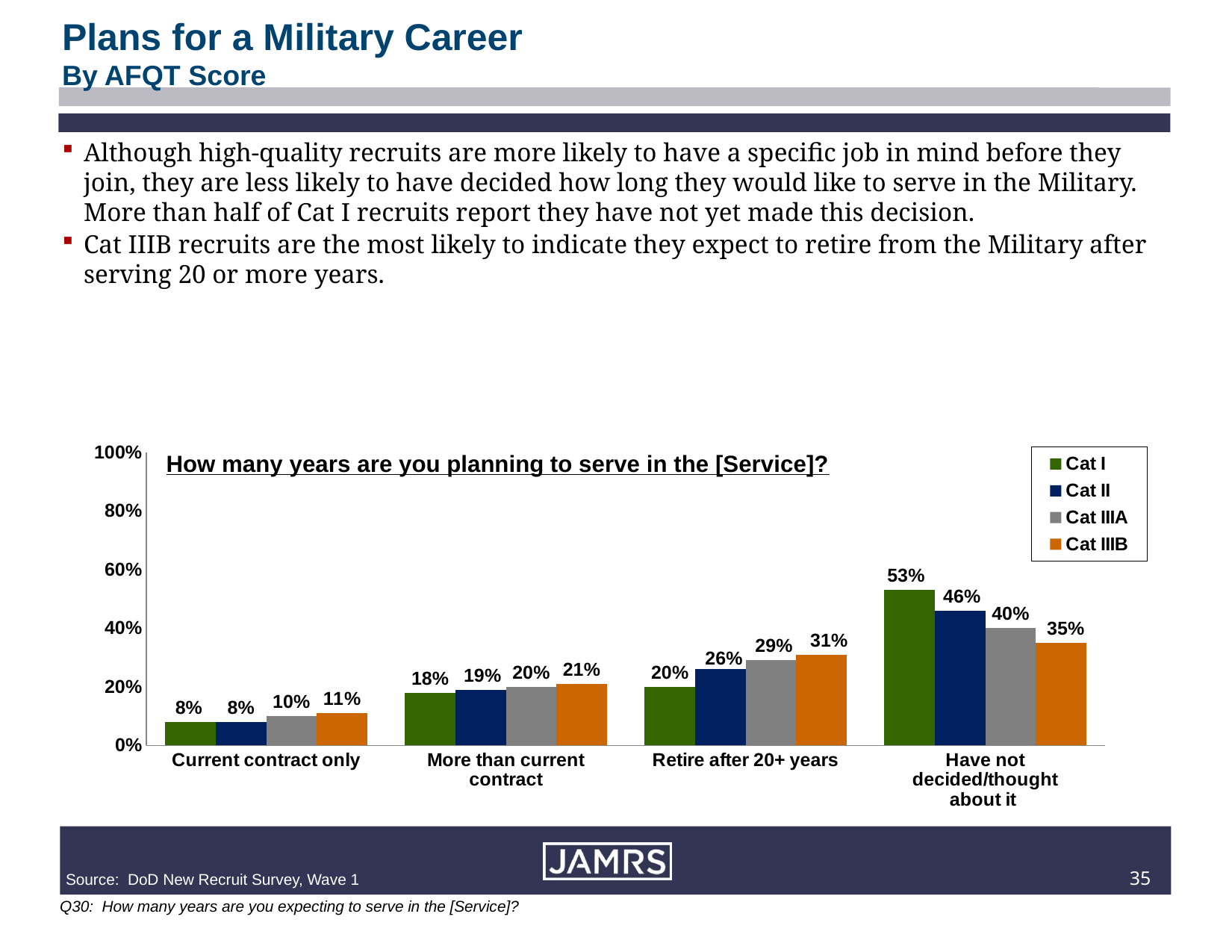
What question is shown as the chart's title? How many years are you planning to serve in the [Service]? What is the value for Cat I in the 'Have not decided/thought about it' category? 53% What is the value for Cat IIIA in the 'Current contract only' category? 10% Which is larger: Cat II in 'Retire after 20+ years' or Cat II in 'More than current contract'? Cat II in 'Retire after 20+ years' What kind of chart is shown on the slide? Bar chart How many series does the legend list? 4 Is the value for Cat II in the 'Have not decided/thought about it' category greater or less than 40%? greater What is the value for Cat IIIB in the 'Retire after 20+ years' category? 31% Which series has the lowest value in the 'Retire after 20+ years' category? Cat I How many categories are shown on the x axis? 4 Which series has the highest value in the 'Have not decided/thought about it' category? Cat I What is the difference between Cat I and Cat IIIB in the 'Have not decided/thought about it' category? 18%